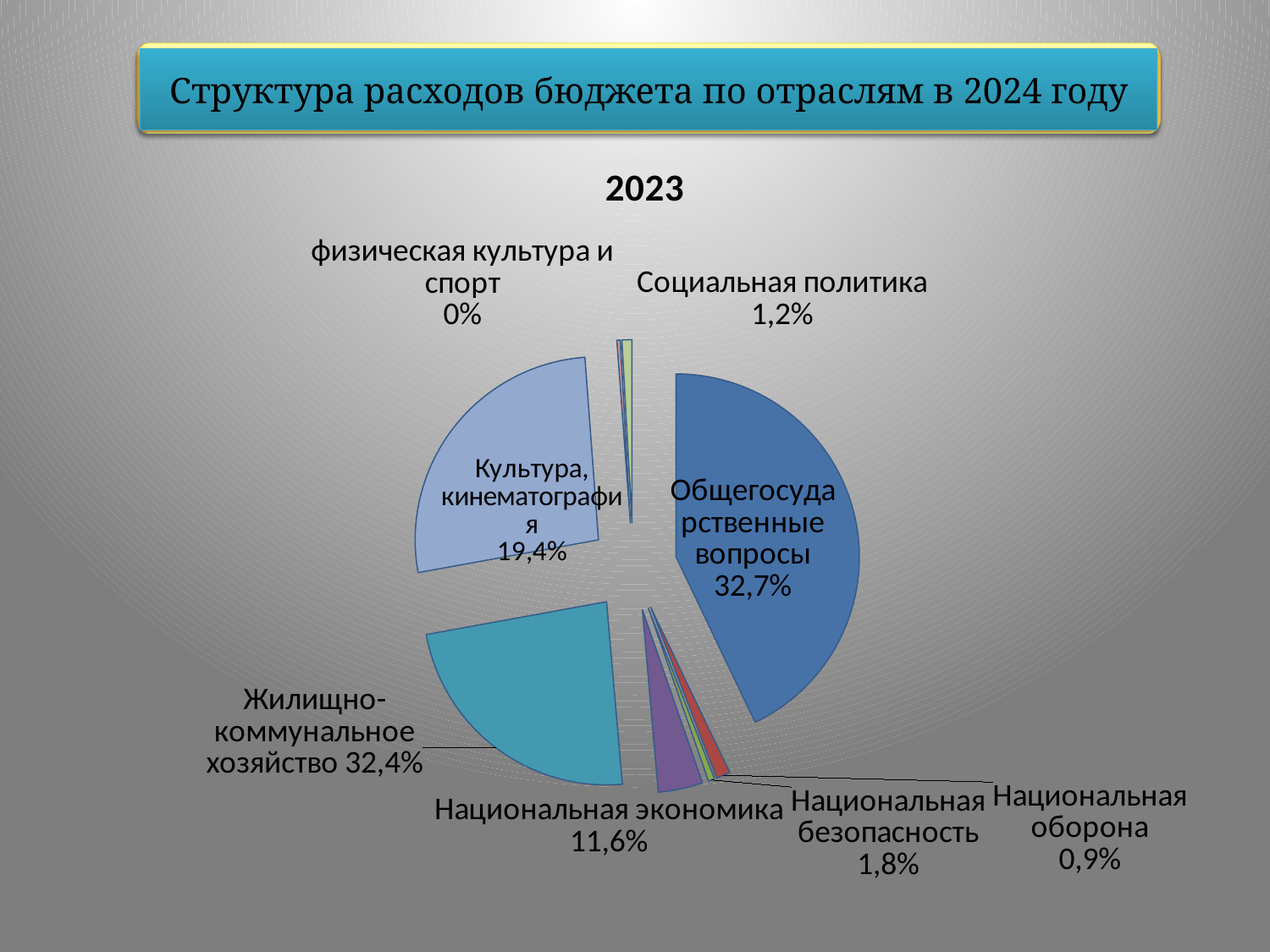
Which labeled category has the smallest share of the pie? физическая культура и спорт What is the value shown for Социальная политика? 1,2% Which category has the largest share of the pie? Общегосударственные вопросы What share of the pie does Жилищно-коммунальное хозяйство have? 32,4% What is the value shown for Национальная экономика? 11,6% Which is larger: the share of Национальная безопасность or Национальная оборона? Национальная безопасность What share of the pie does Общегосударственные вопросы have? 32,7% What is the value shown for Культура, кинематография? 19,4% What is the value shown for Национальная оборона? 0,9% What is the difference between the shares of Культура, кинематография and Национальная экономика? 7,8% What is the title of the chart? 2023 What kind of chart is shown on the slide? Pie chart